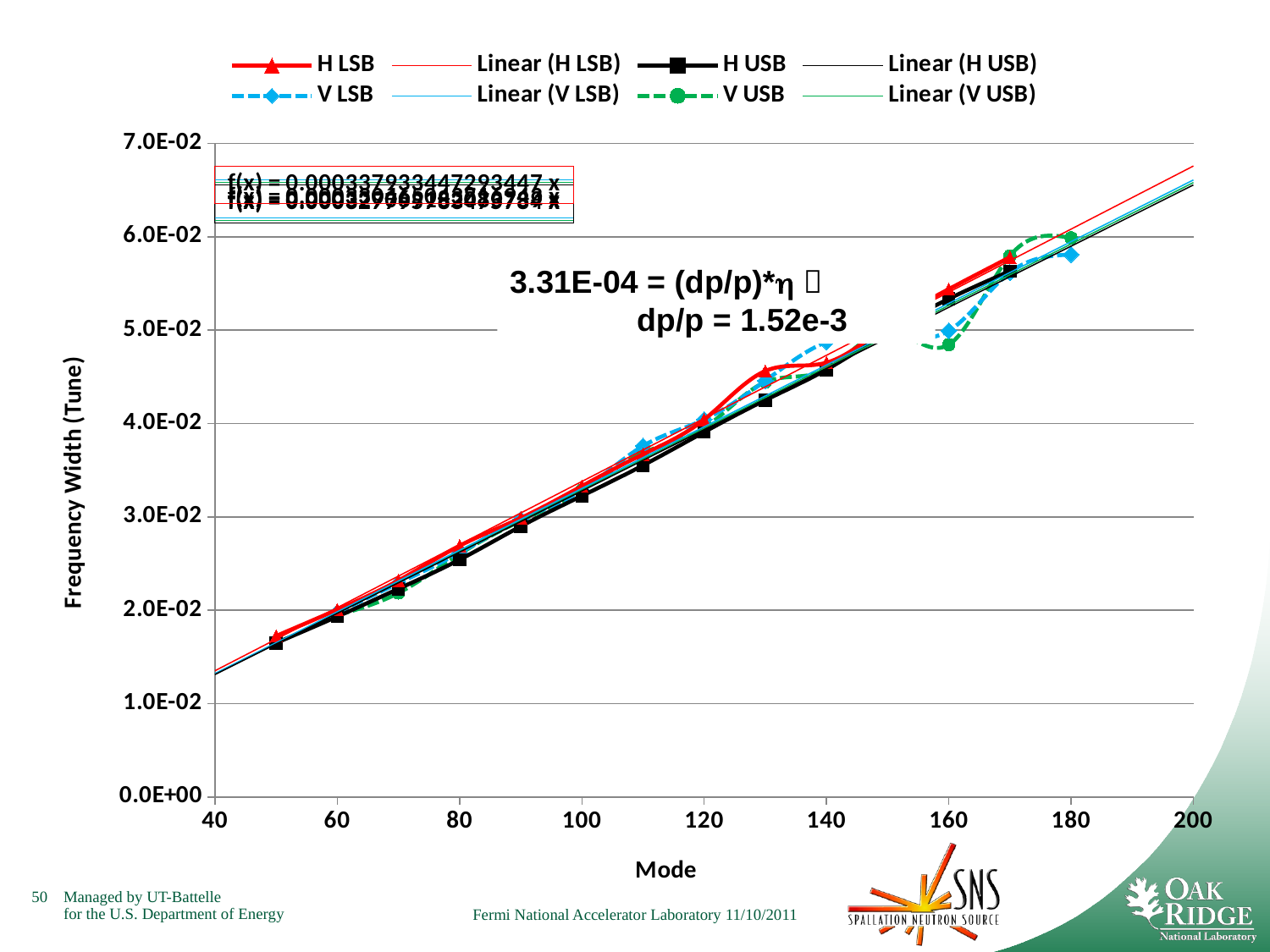
Do the H USB values rise or fall as Mode increases from 40 to 200? rise What is the title of the vertical axis? Frequency Width (Tune) At Mode 130, which series has the larger value, H LSB or H USB? H LSB Is the H USB value at Mode 130 greater or less than 4.0E-02? greater Is the H USB value at Mode 80 greater or less than 2.0E-02? greater Is the H LSB value at Mode 140 greater or less than 5.0E-02? less What is the title of the horizontal axis? Mode What kind of chart is shown on the slide? line chart At Mode 160, which series has the larger value, H LSB or V USB? H LSB How many entries does the legend list? 8